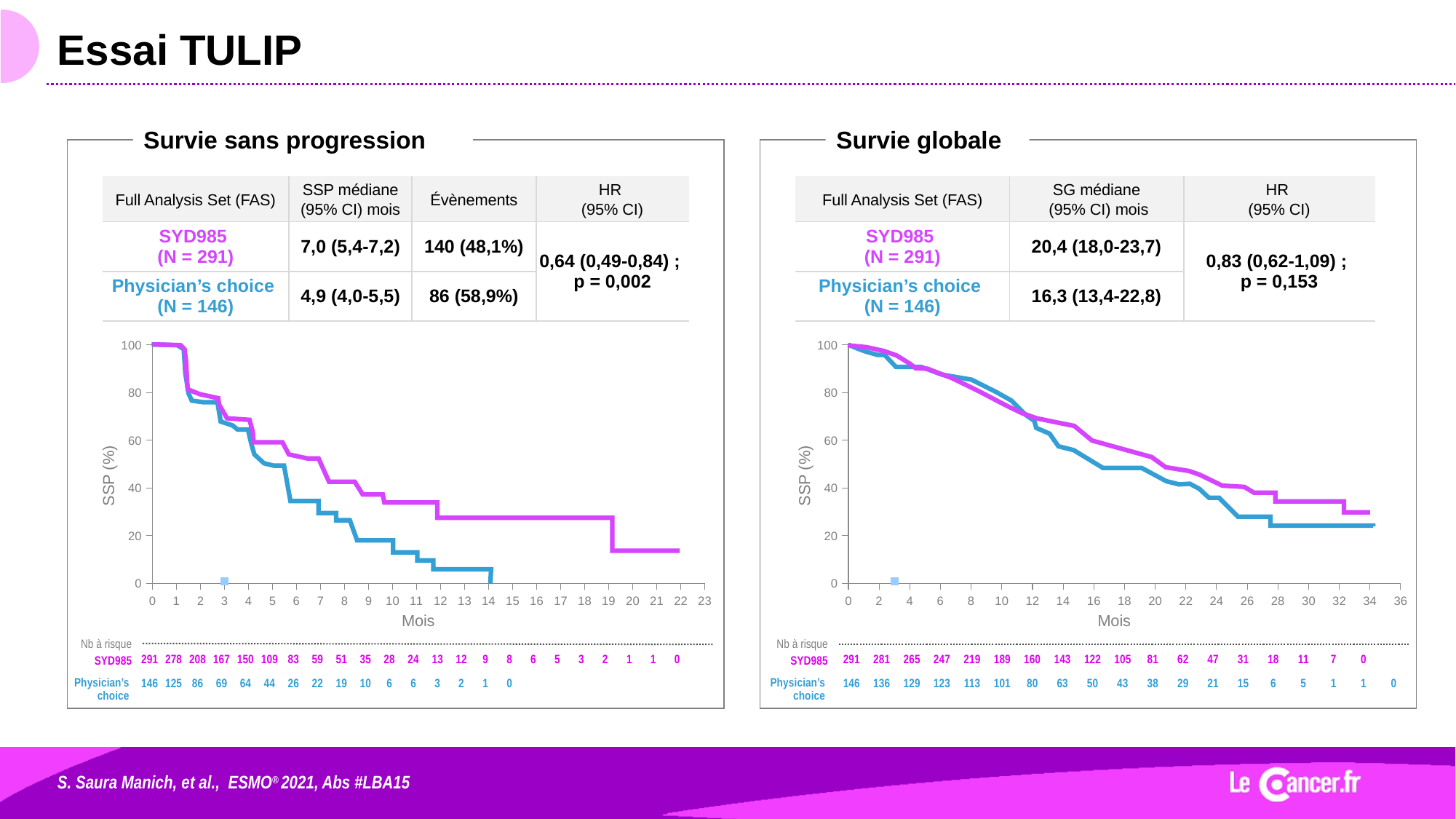
On the 'Survie sans progression' chart, how many SYD985 patients were at risk (Nb à risque) at 3 months? 167 On the 'Survie globale' chart, what is the difference in median OS between SYD985 (20,4) and Physician's choice (16,3)? 4,1 mois On the 'Survie sans progression' chart, which arm has the higher median PFS, SYD985 or Physician's choice? SYD985 On the 'Survie sans progression' chart, what is the median PFS (SSP médiane) for SYD985? 7,0 (5,4-7,2) On the 'Survie sans progression' chart, what is the hazard ratio (HR) with its 95% CI and p-value? 0,64 (0,49-0,84) ; p = 0,002 What kind of chart is used on the 'Survie globale' panel? Line chart (Kaplan-Meier survival curves) On the 'Survie globale' chart, what is the median OS (SG médiane) for SYD985? 20,4 (18,0-23,7) On the 'Survie globale' chart, how many Physician's choice patients were at risk (Nb à risque) at 12 months? 80 On the 'Survie globale' chart, what is the median OS (SG médiane) for Physician's choice? 16,3 (13,4-22,8) On the 'Survie sans progression' chart, what is the median PFS (SSP médiane) for Physician's choice? 4,9 (4,0-5,5) On the 'Survie sans progression' chart, how many events (Évènements) were recorded for SYD985? 140 (48,1%) On the 'Survie globale' chart, what is the p-value for the hazard ratio? p = 0,153